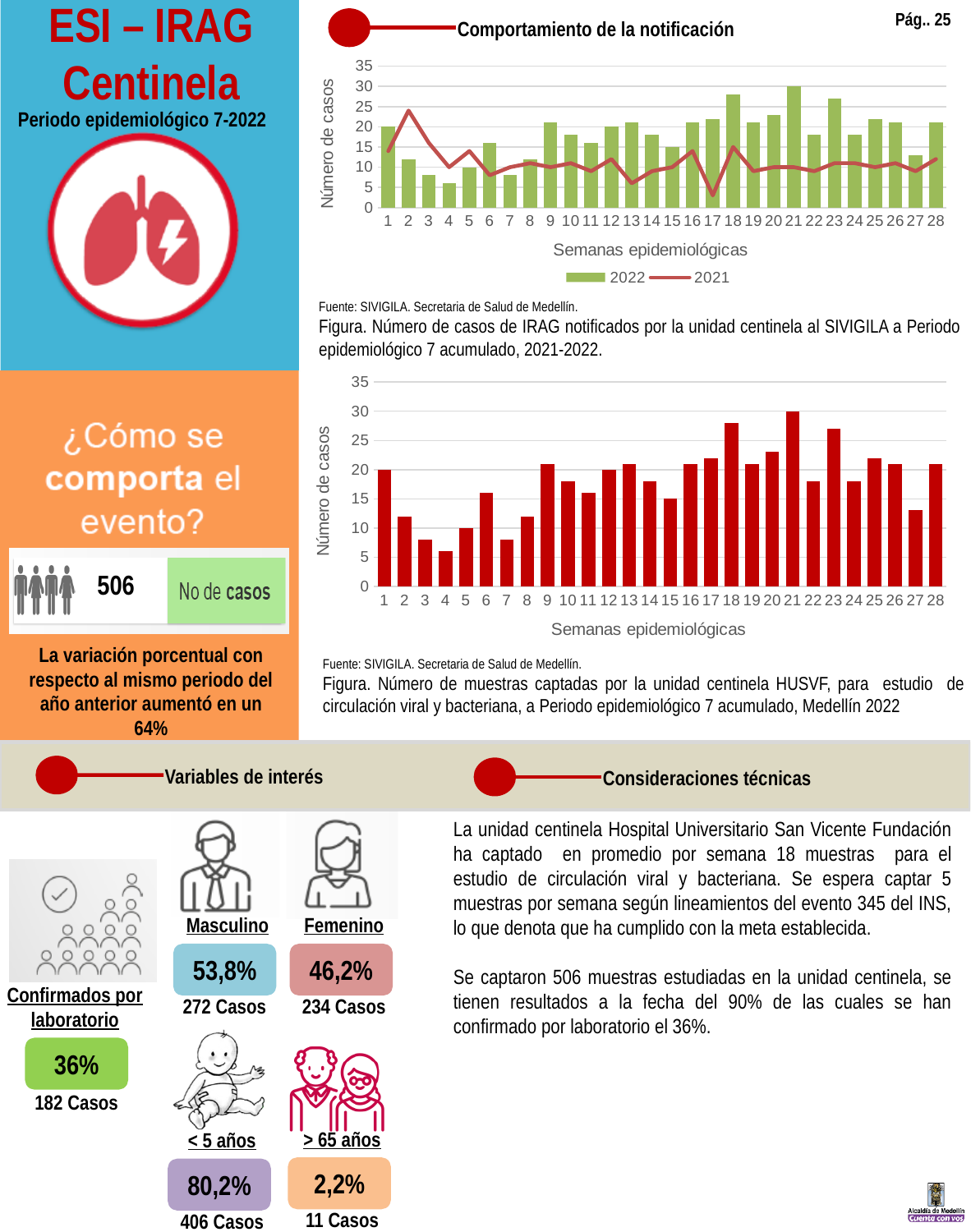
In the bottom chart, how many epidemiological weeks are shown on the x axis? 28 In the top chart, which epidemiological week has the lowest 2022 bar? 4 In the bottom chart (Número de muestras captadas), what kind of chart is it? bar chart In the top chart, what are the two series named in the legend? 2022 and 2021 In the top chart, is the 2022 value for week 3 greater or less than 10? less In the bottom chart, is the value for week 27 greater or less than 15? less In the top chart, is the 2021 value for week 2 greater or less than 20? greater In the top chart, how many series does the legend list? 2 In the top chart (Comportamiento de la notificación), which epidemiological week has the highest 2022 bar? 21 In the bottom chart, which is larger, the value for week 9 or the value for week 4? week 9